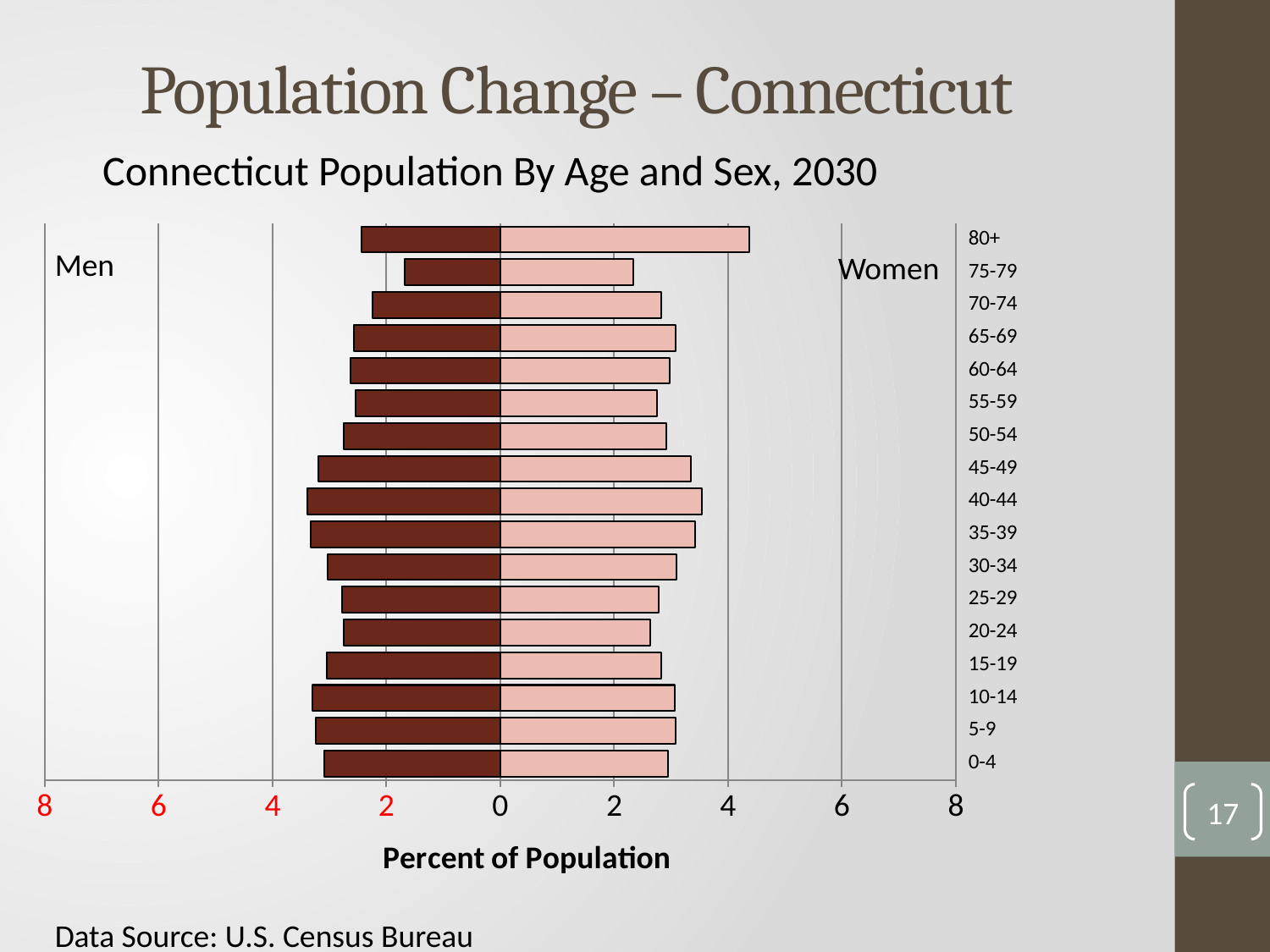
Is the value for Men aged 40-44 greater or less than 2? greater Is the value for Women aged 80+ greater or less than 4? greater What is the label on the horizontal axis of the chart? Percent of Population Is the value for Men aged 75-79 greater or less than 2? less For the 80+ age group, which is larger, the value for Men or the value for Women? Women How many age groups are plotted on the chart? 17 What is the title of the chart? Connecticut Population By Age and Sex, 2030 Which age group has the lowest value for Men? 75-79 How many series does the chart show? 2 Which age group has the lowest value for Women? 75-79 Which age group has the highest value for Women? 80+ What kind of chart is shown on the slide? Bar chart